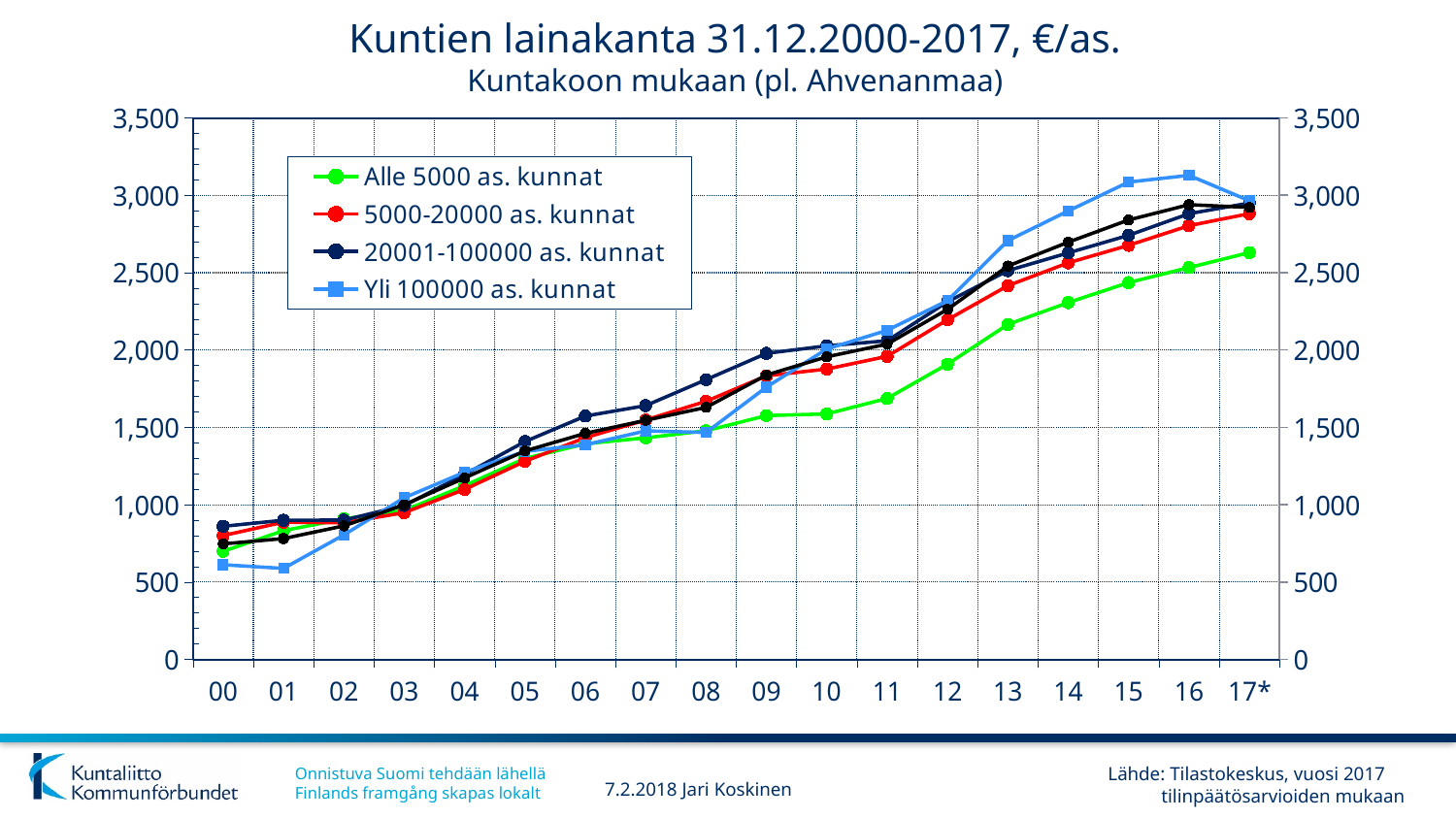
How many series does the legend list? 4 Is the value for Yli 100000 as. kunnat in 16 greater or less than 3,000? greater Does the value for Alle 5000 as. kunnat rise or fall from 00 to 17*? rise Which series has the highest value in 16? Yli 100000 as. kunnat Which series has the lowest value in 16? Alle 5000 as. kunnat What is the title of the chart? Kuntien lainakanta 31.12.2000-2017, €/as. Which series has the lowest value in 00? Yli 100000 as. kunnat How many years are shown along the x axis? 18 Which series is drawn with a green line? Alle 5000 as. kunnat What kind of chart is shown on the slide? line chart Is the value for Alle 5000 as. kunnat in 10 greater or less than 2,000? less In which year does Yli 100000 as. kunnat reach its highest value? 16